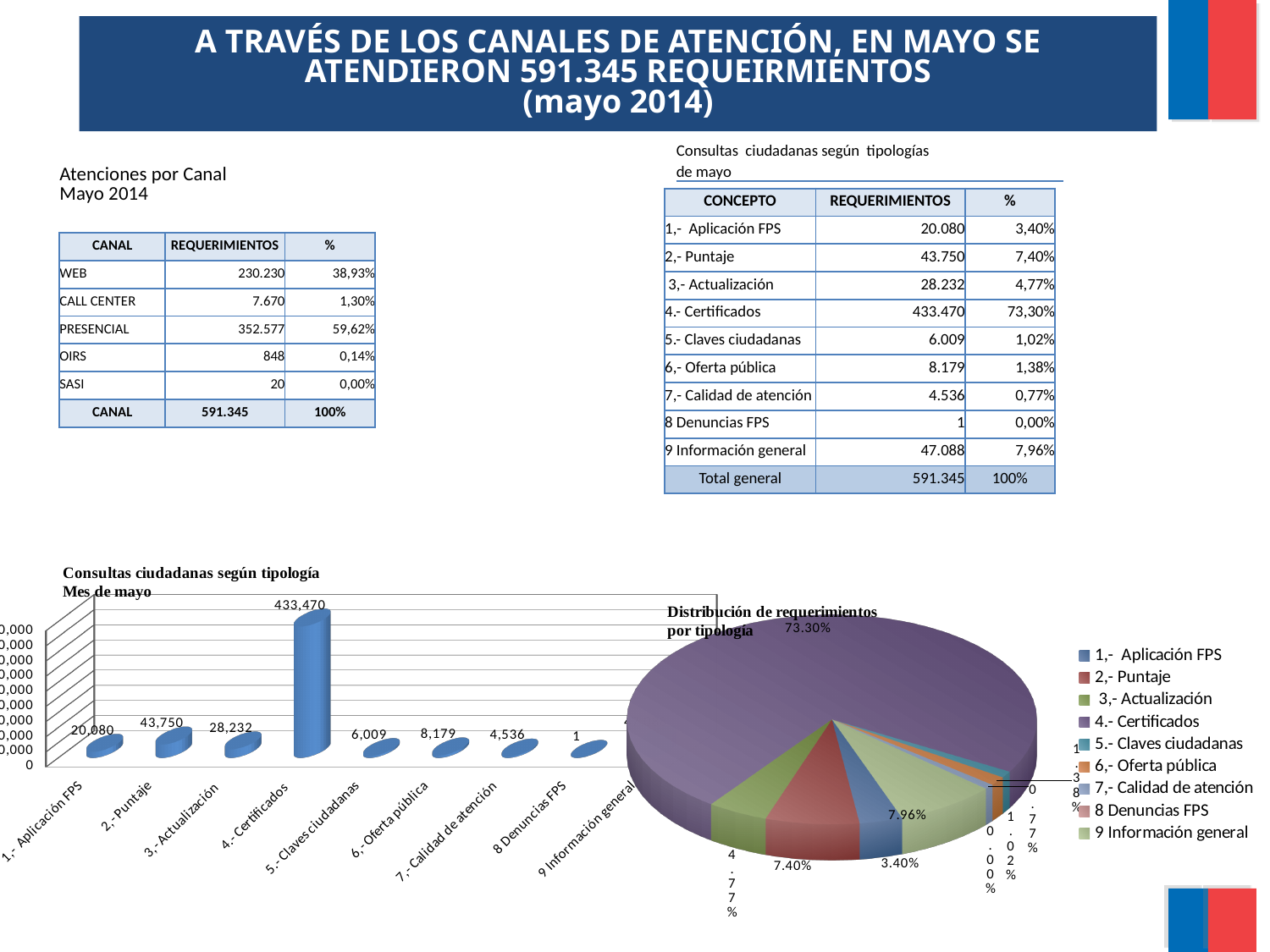
In the bar chart 'Consultas ciudadanas según tipología', which category has the highest value? 4.- Certificados In the bar chart 'Consultas ciudadanas según tipología', what is the value for 2,- Puntaje? 43,750 In the bar chart 'Consultas ciudadanas según tipología', what is the value for 4.- Certificados? 433,470 In the bar chart 'Consultas ciudadanas según tipología', what is the difference between the values for 2,- Puntaje and 3,- Actualización? 15,518 What kind of chart is 'Consultas ciudadanas según tipología'? Bar chart In the bar chart 'Consultas ciudadanas según tipología', what is the value for 8 Denuncias FPS? 1 How many entries does the legend of the pie chart 'Distribución de requerimientos por tipología' list? 9 In the pie chart 'Distribución de requerimientos por tipología', what share does 9 Información general have? 7.96% In the bar chart 'Consultas ciudadanas según tipología', which category has the lowest value? 8 Denuncias FPS In the pie chart 'Distribución de requerimientos por tipología', what share does 4.- Certificados have? 73.30% In the bar chart 'Consultas ciudadanas según tipología', which is larger: the value for 5.- Claves ciudadanas or 6,- Oferta pública? 6,- Oferta pública How many categories are shown in the bar chart 'Consultas ciudadanas según tipología'? 9